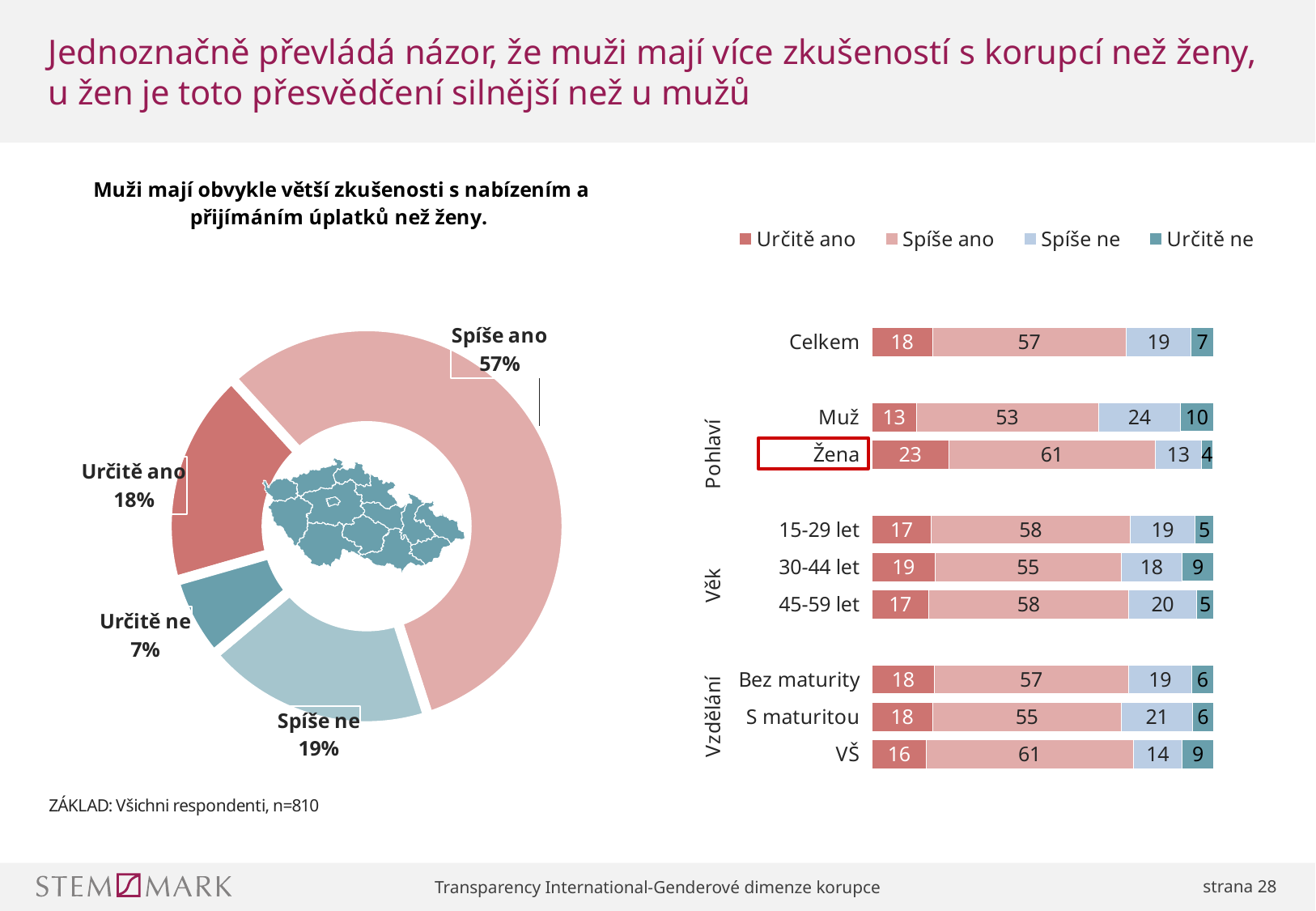
In the donut chart on the left, what is the difference between the "Spíše ne" and "Určitě ne" shares? 12% In the stacked bar chart on the right, how many categories (bars) are shown? 9 In the stacked bar chart on the right, what is the "Spíše ne" value for Muž? 24 What kind of chart is shown on the left side of the slide? Donut (pie) chart In the donut chart on the left, what share of respondents answered "Spíše ano"? 57% In the stacked bar chart on the right, is the "Spíše ano" value larger for VŠ or for S maturitou? VŠ In the stacked bar chart on the right, which category has the highest "Určitě ano" value? Žena In the donut chart on the left, which answer has the smallest share? Určitě ne In the stacked bar chart on the right, how many series does the legend list? 4 In the stacked bar chart on the right, what is the difference between the "Určitě ano" values for Žena and Muž? 10 In the stacked bar chart on the right, what is the "Určitě ano" value for Žena? 23 In the stacked bar chart on the right, which category has the lowest "Určitě ne" value? Žena